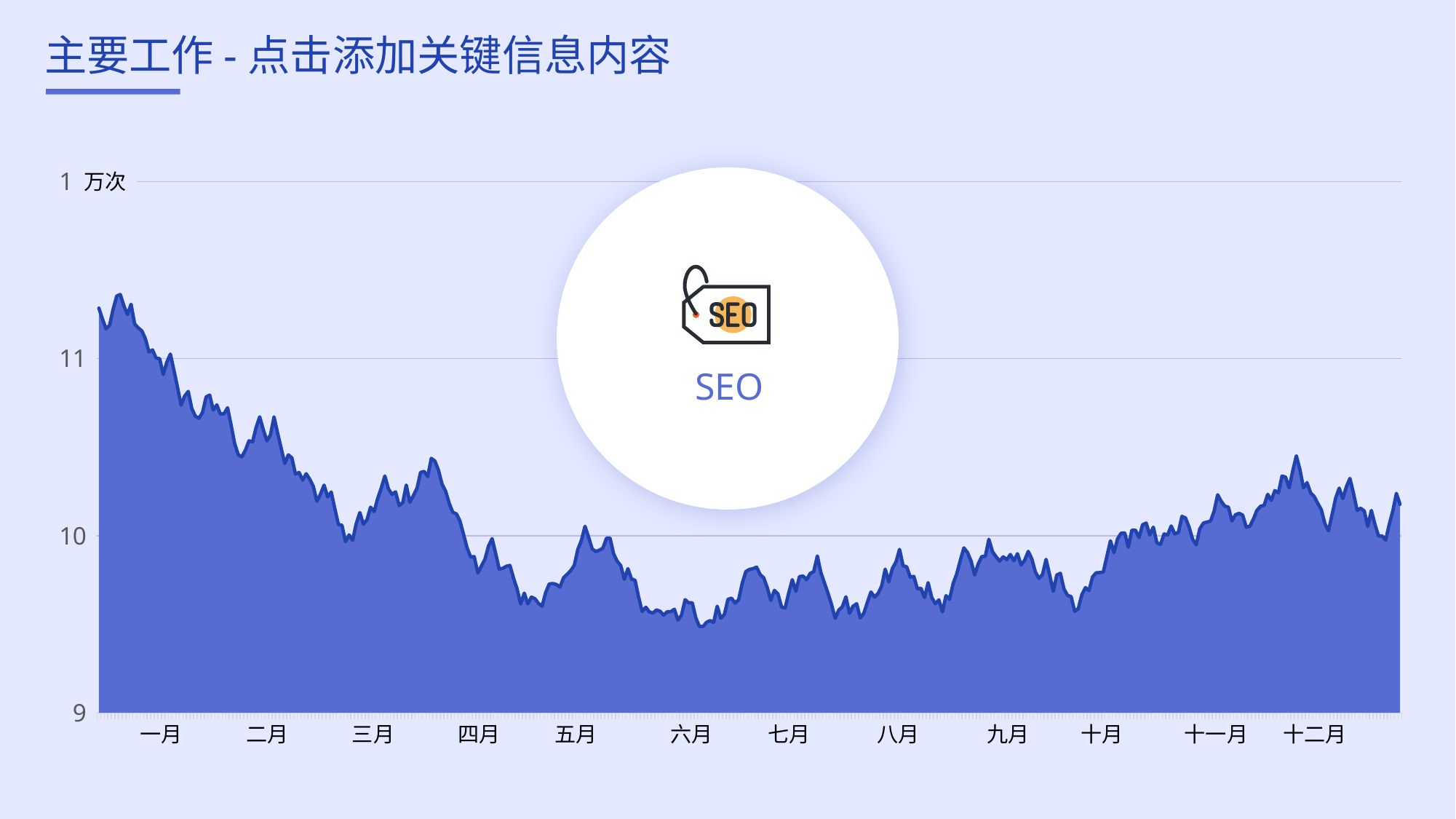
Is the value during 三月 greater or less than 11? less Do the values rise or fall from 六月 to 十二月? rise Is the value during 十二月 greater or less than 10? greater Is the value during 六月 greater or less than 10? less What kind of chart is shown on the slide? Area chart What is the title of the slide? 主要工作 - 点击添加关键信息内容 How many months are labelled along the x axis of the chart? 12 In which month does the chart reach its highest value? 一月 Do the values rise or fall from 一月 to 六月? fall Which is larger, the value in 一月 or the value in 六月? 一月